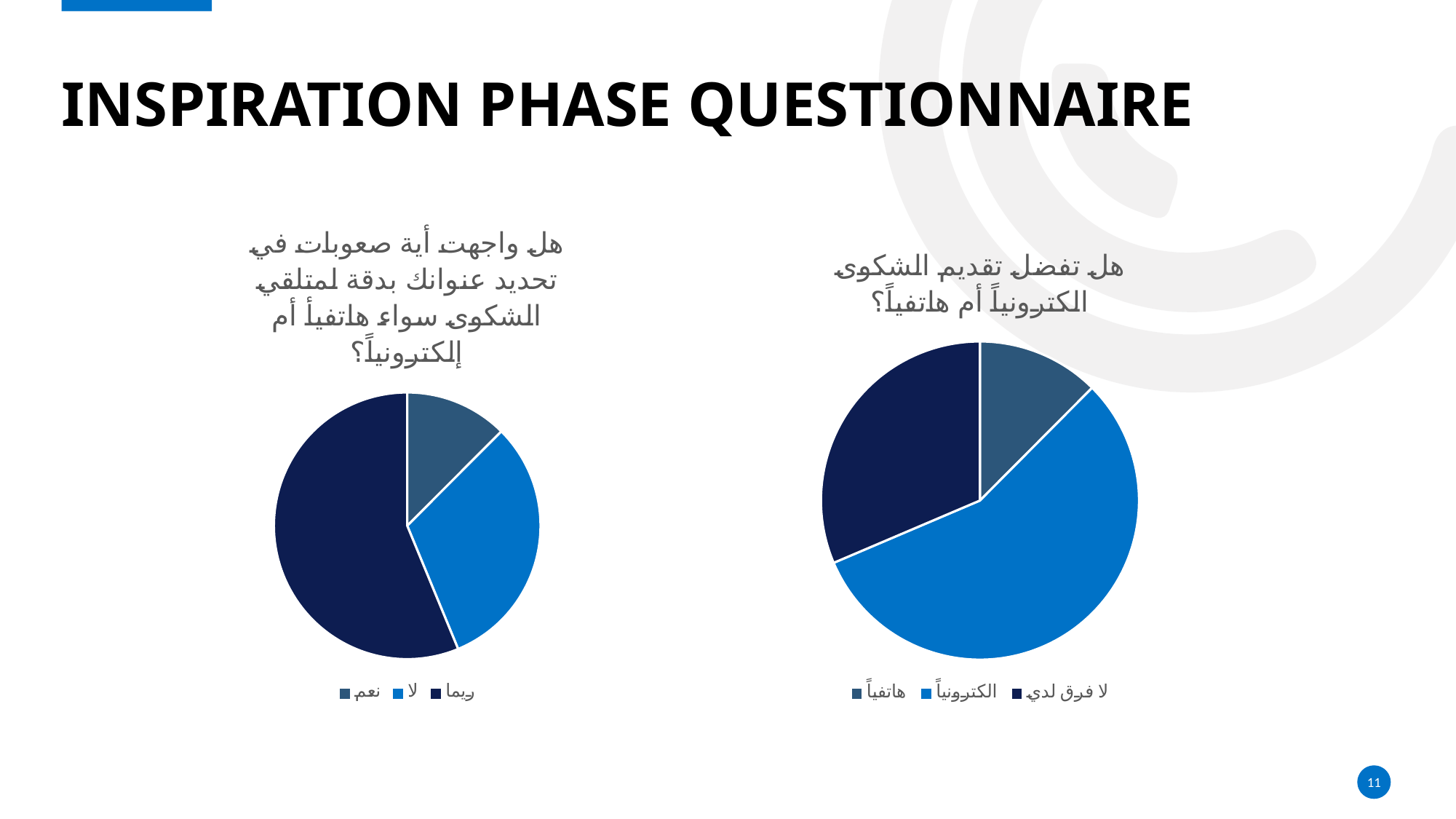
In the left pie chart, which category has the largest slice? ريما In the left pie chart, which slice is larger: لا or ربما? ريما How many entries does the legend of the right pie chart list? 3 How many entries does the legend of the left pie chart list? 3 How many slices does the right pie chart have? 3 In the right pie chart, which category has the largest slice? الكترونياً In the left pie chart, which category has the smallest slice? نعم What kind of chart is the left chart on the slide? pie chart What kind of chart is the right chart on the slide? pie chart In the right pie chart, which category has the smallest slice? هاتفياً How many slices does the left pie chart have? 3 In the right pie chart, which slice is larger: الكترونياً or لا فرق لدي? الكترونياً